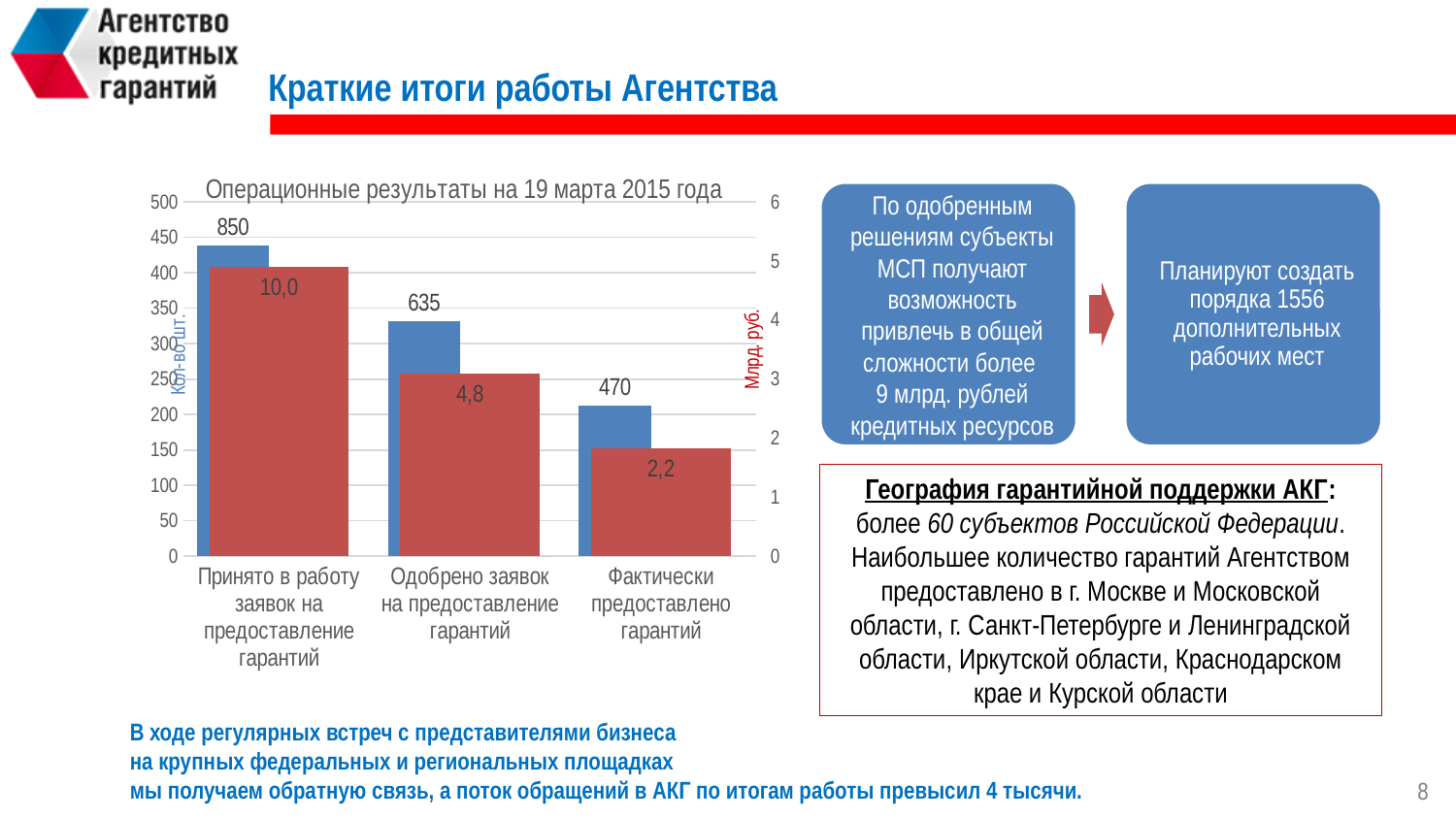
Which category has the lowest value in млрд. руб.? Фактически предоставлено гарантий How many categories are shown on the x axis of the chart? 3 What is the value in млрд. руб. for 'Принято в работу заявок на предоставление гарантий'? 10,0 What is the number (шт.) for 'Фактически предоставлено гарантий'? 470 What is the difference in number (шт.) between 'Принято в работу заявок на предоставление гарантий' and 'Фактически предоставлено гарантий'? 380 Which category has the highest number of applications (шт.)? Принято в работу заявок на предоставление гарантий What is the number (шт.) for 'Принято в работу заявок на предоставление гарантий'? 850 Do the values in млрд. руб. rise or fall from left to right across the categories? fall What type of chart is shown on the slide? bar chart What is the number (шт.) for 'Одобрено заявок на предоставление гарантий'? 635 What is the value in млрд. руб. for 'Фактически предоставлено гарантий'? 2,2 What is the title of the chart? Операционные результаты на 19 марта 2015 года